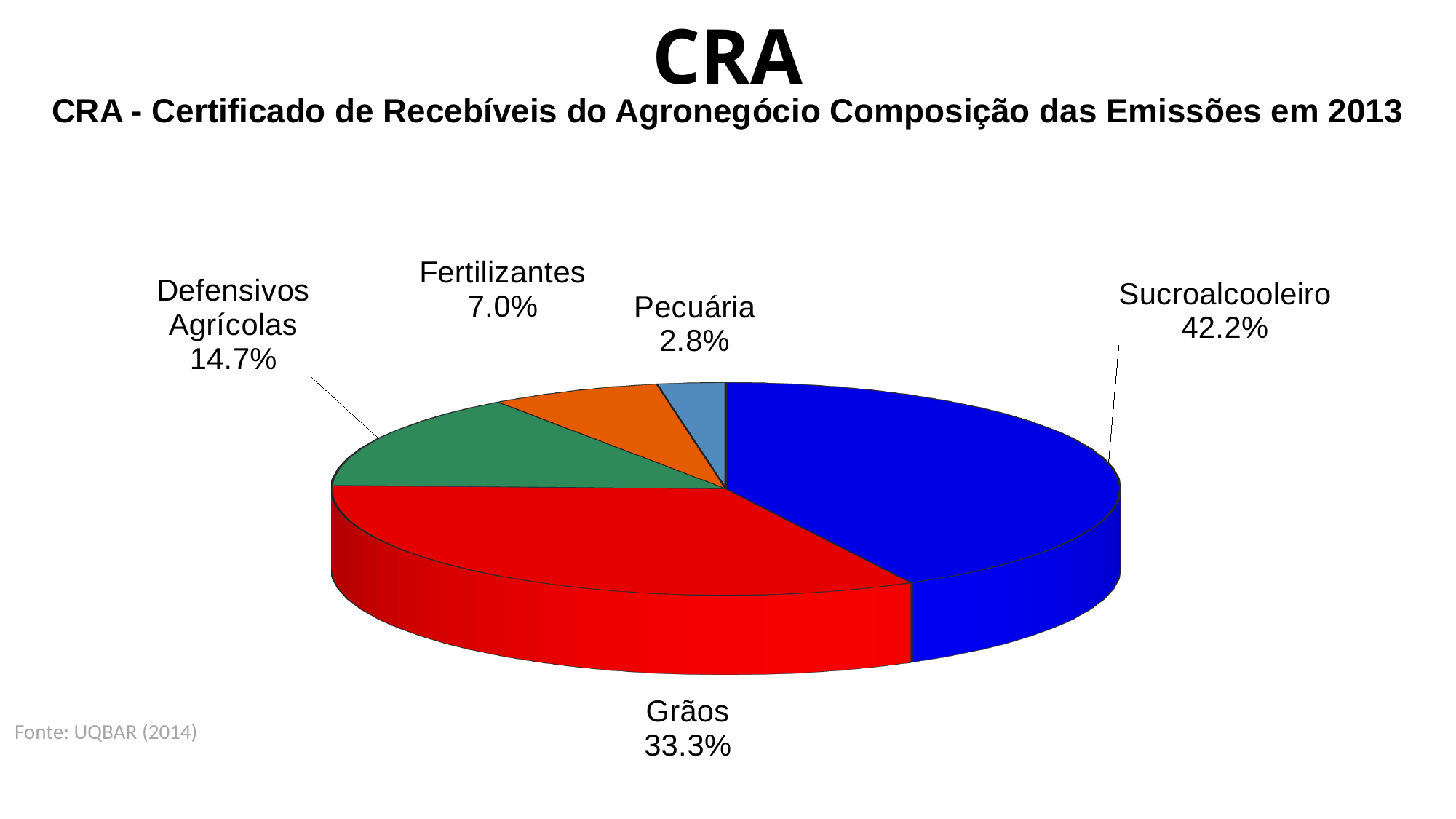
What kind of chart is shown on the slide? Pie chart Which category has the smallest slice of the pie? Pecuária How many categories are shown in the pie chart? 5 What is the value shown for Fertilizantes? 7.0% What colour is the Grãos slice? Red Which category has the largest slice of the pie? Sucroalcooleiro Which is larger, Defensivos Agrícolas or Fertilizantes? Defensivos Agrícolas What is the value shown for Defensivos Agrícolas? 14.7% What is the value shown for Pecuária? 2.8% What share of the pie does Sucroalcooleiro have? 42.2% What is the difference in percentage points between Sucroalcooleiro and Grãos? 8.9 What is the value shown for Grãos? 33.3%